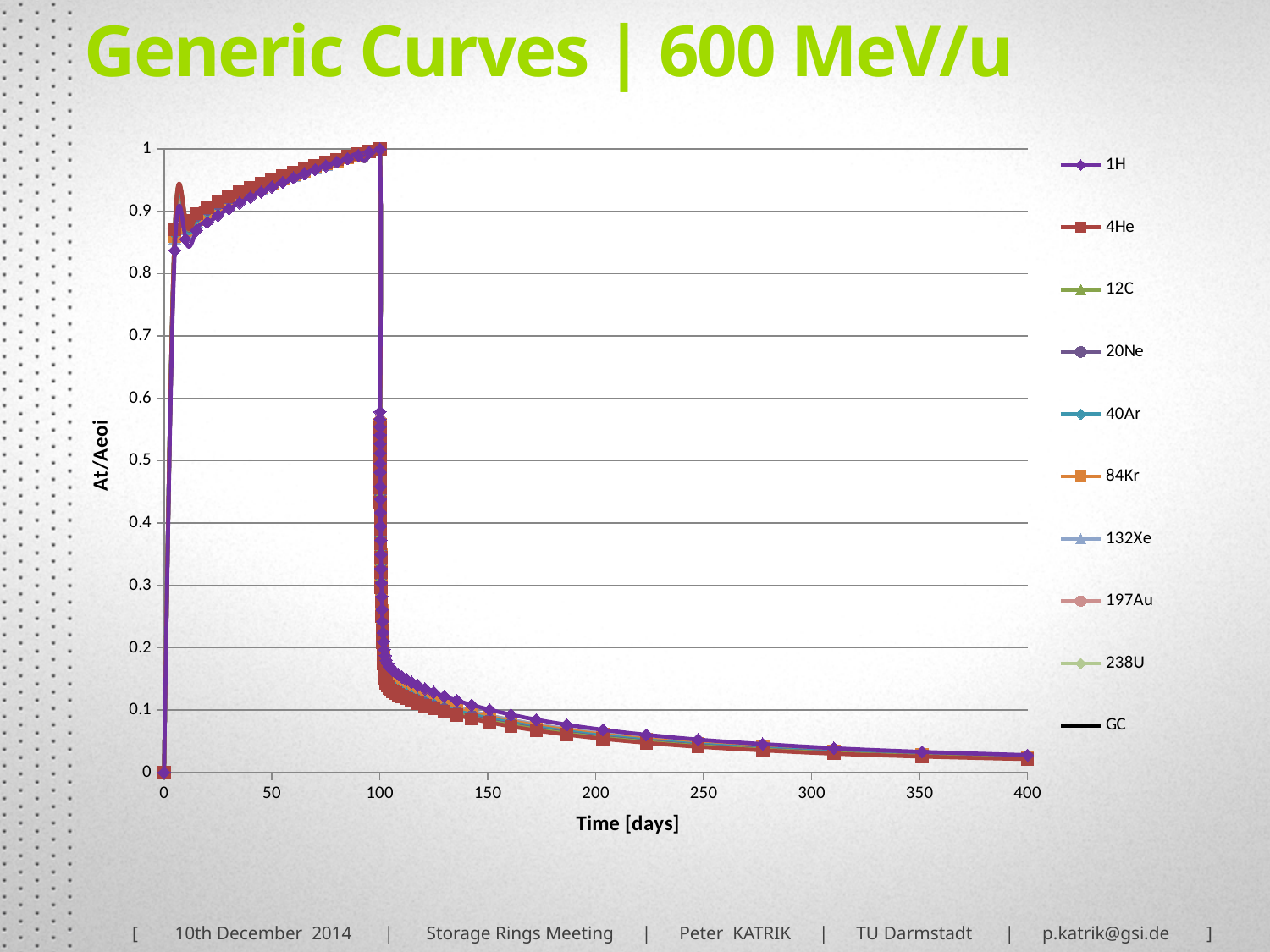
How many series does the legend list? 10 Do the curves rise or fall between 100 and 400 days? fall Is the value of the curves at 50 days greater or less than 0.9? greater Do the curves rise or fall between 20 and 100 days? rise Is the value of the curves at 200 days greater or less than 0.1? less Is the value of the curves at 75 days greater or less than 0.9? greater What kind of chart is shown on the slide? line chart What is the maximum value the curves reach at 100 days? 1 What is the title of the slide's chart? Generic Curves | 600 MeV/u What is the label of the x axis? Time [days]